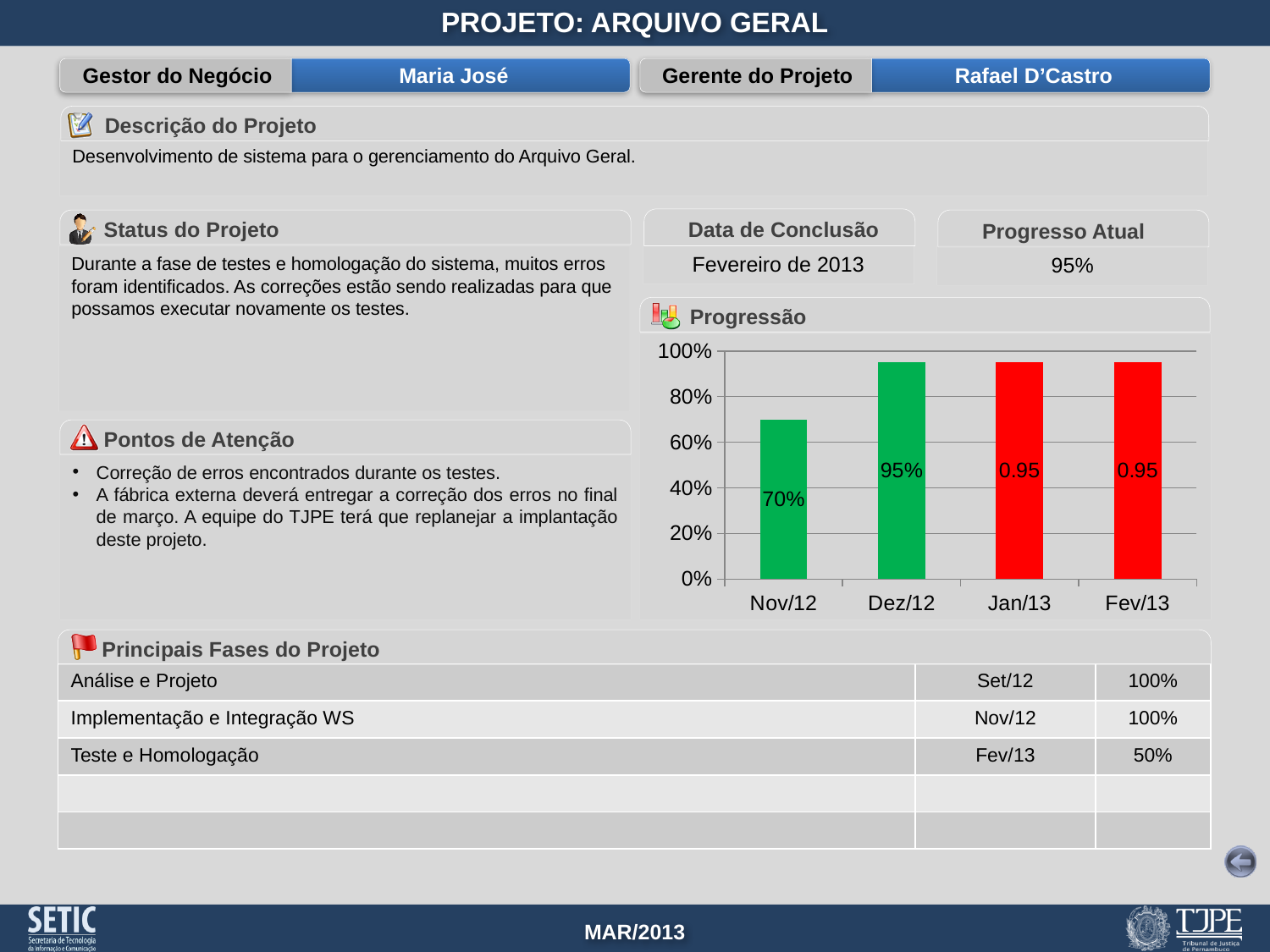
What kind of chart is the Progressão chart? bar chart In the Progressão chart, what data label is shown on the Fev/13 bar? 0.95 In the Progressão chart, what is the difference between the Dez/12 and Nov/12 values? 25% In the Progressão chart, what is the value for Nov/12? 70% In the Progressão chart, what colour are the Jan/13 and Fev/13 bars? red In the Progressão chart, what data label is shown on the Jan/13 bar? 0.95 In the Progressão chart, what is the value for Dez/12? 95% In the Progressão chart, does the value rise or fall from Nov/12 to Dez/12? rise In the Progressão chart, which is larger, the value for Nov/12 or the value for Dez/12? Dez/12 How many months are shown on the x axis of the Progressão chart? 4 In the Progressão chart, which month has the lowest value? Nov/12 In the Progressão chart, is the value for Nov/12 greater or less than 60%? greater